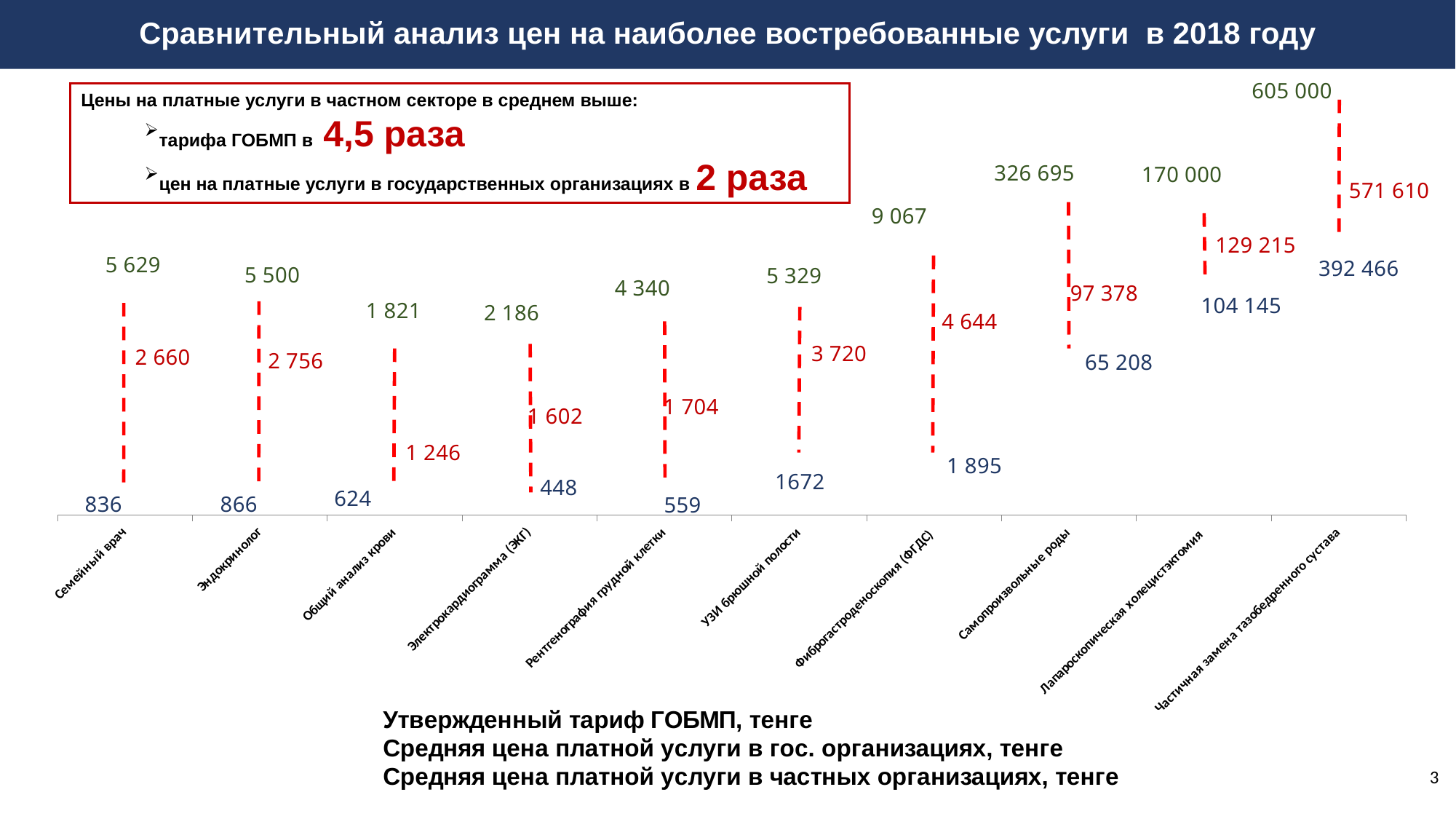
How many services are shown on the x axis of the chart? 10 What is the title of the slide's chart? Сравнительный анализ цен на наиболее востребованные услуги в 2018 году According to the text box on the slide, how many times higher are private-sector prices than the GOBMP tariff on average? 4,5 раза How many series does the chart legend list? 3 What is the average price of the paid service in state organizations for Самопроизвольные роды? 97 378 Which is larger: the state-organization price for УЗИ брюшной полости or the state-organization price for Рентгенография грудной клетки? УЗИ брюшной полости Which service has the highest average price in private organizations? Частичная замена тазобедренного сустава Which service has the lowest approved GOBMP tariff? Электрокардиограмма (ЭКГ) What is the approved GOBMP tariff for Частичная замена тазобедренного сустава? 392 466 What is the difference between the private-organization price and the GOBMP tariff for Эндокринолог? 4 634 What is the approved GOBMP tariff (Утвержденный тариф ГОБМП) for Семейный врач? 836 What is the average price of the paid service in private organizations for Фиброгастродуоденоскопия (ФГДС)? 9 067